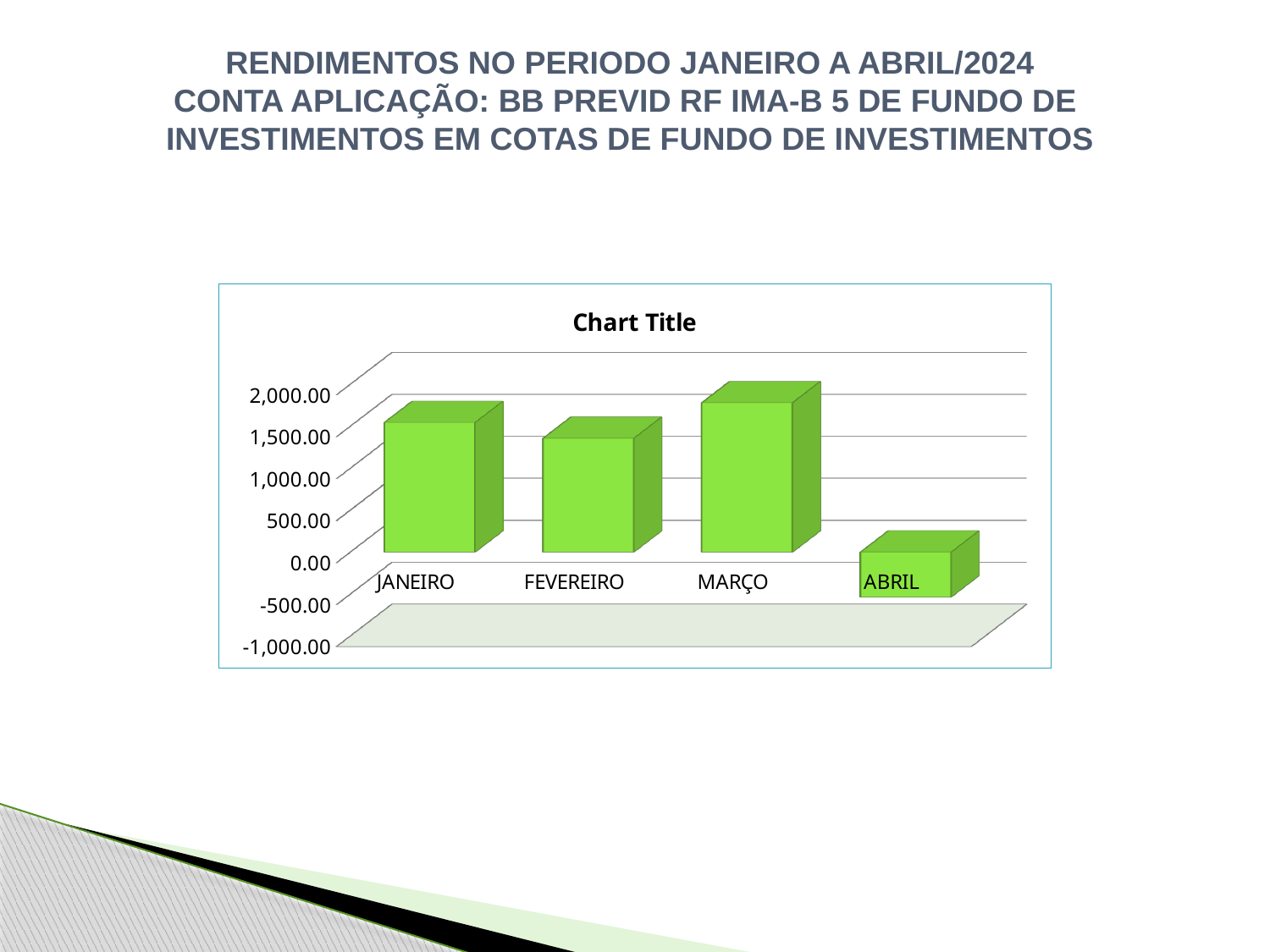
How many categories (months) are plotted on the chart? 4 Is the value for ABRIL greater or less than 0.00? less Which month has the highest value on the chart? MARÇO What colour are the bars in the chart? green Which is larger, the value for JANEIRO or the value for FEVEREIRO? JANEIRO Is the value for MARÇO greater or less than 1,500.00? greater What is the title printed above the chart's plot area? Chart Title Which month has the lowest value on the chart? ABRIL What kind of chart is shown on the slide? bar chart Which is larger, the value for MARÇO or the value for JANEIRO? MARÇO Is the value for FEVEREIRO greater or less than 1,000.00? greater